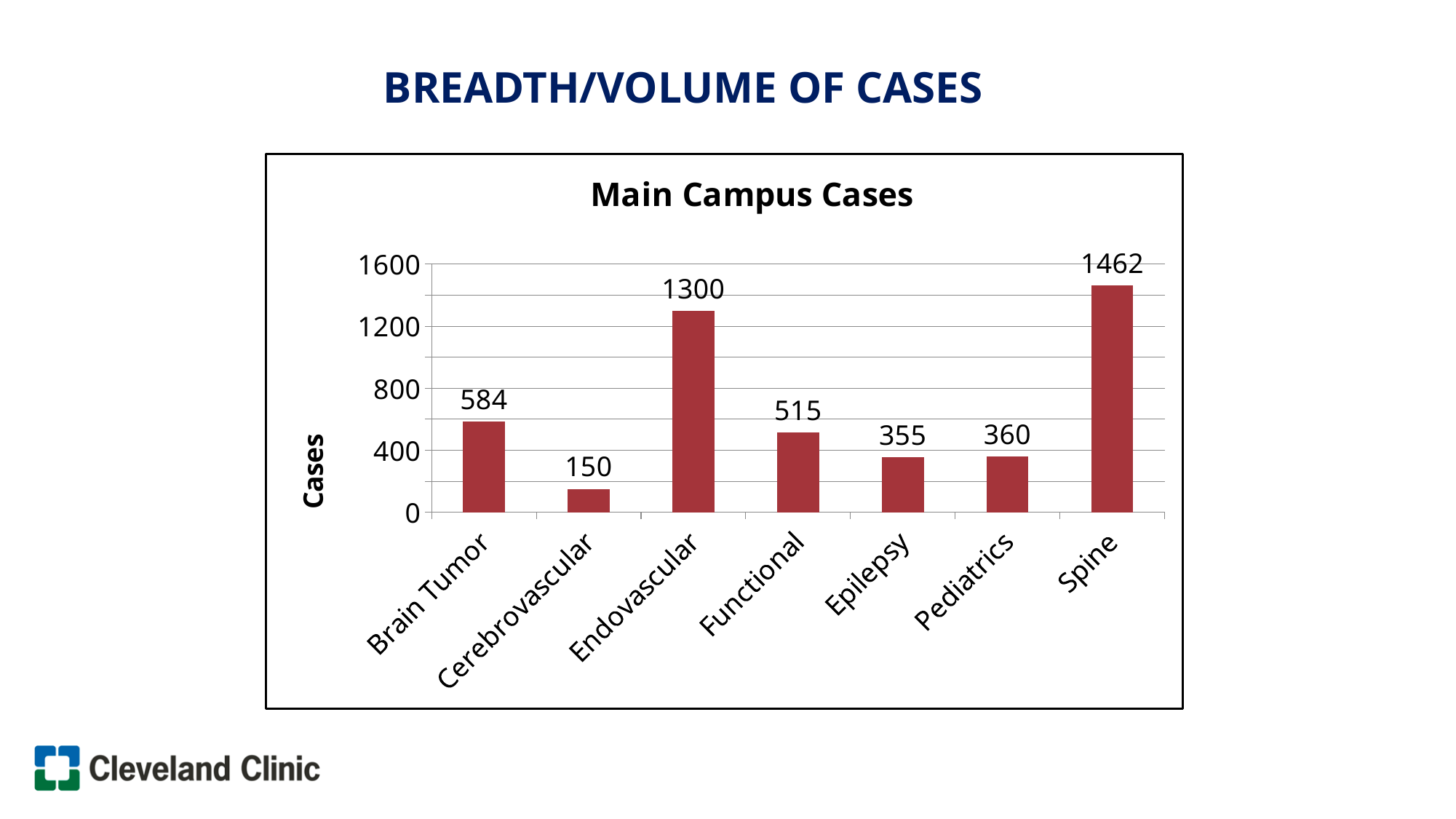
How many categories are shown on the x axis? 7 What is the title of the chart? Main Campus Cases What is the difference in cases between Spine and Endovascular? 162 What is the number of cases for Endovascular? 1300 What is the number of cases for Pediatrics? 360 Which has more cases, Brain Tumor or Functional? Brain Tumor What is the number of cases for Brain Tumor? 584 Which category has the lowest number of cases? Cerebrovascular What is the number of cases for Cerebrovascular? 150 Is the value for Epilepsy greater or less than 400? less Which category has the highest number of cases? Spine What kind of chart is shown on the slide? bar chart